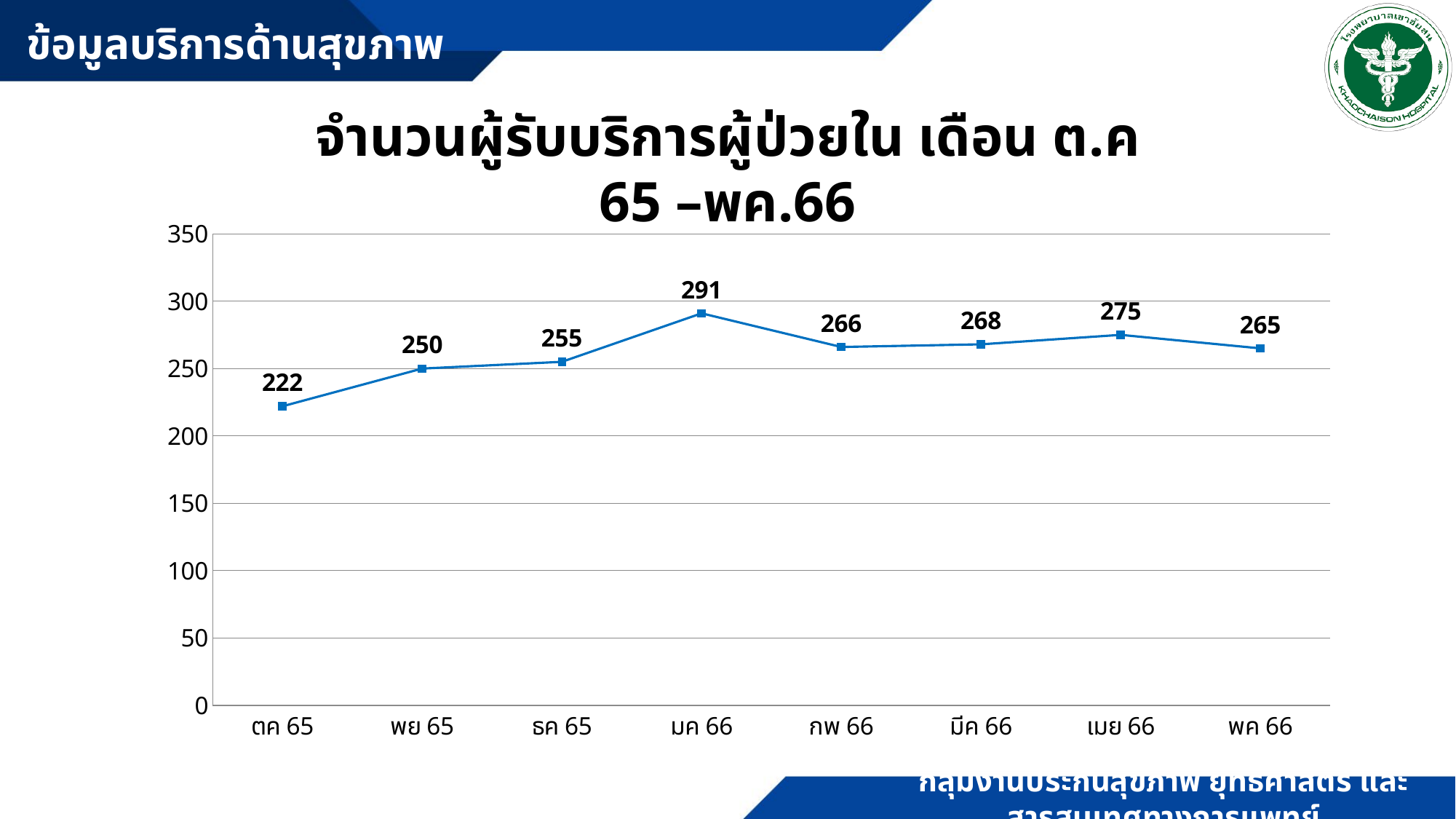
Which month has the highest value? มค 66 Which month has the lowest value? ตค 65 Is the value for กพ 66 greater or less than 300? less What kind of chart is shown on the slide? line chart What is the value for พค 66? 265 Which is larger, the value for พย 65 or the value for ธค 65? ธค 65 What is the value for เมย 66? 275 What is the value for ตค 65? 222 How many months are plotted on the chart? 8 What is the difference between the values for มค 66 and ตค 65? 69 Do the values rise or fall from ตค 65 to มค 66? rise What is the value for มค 66? 291